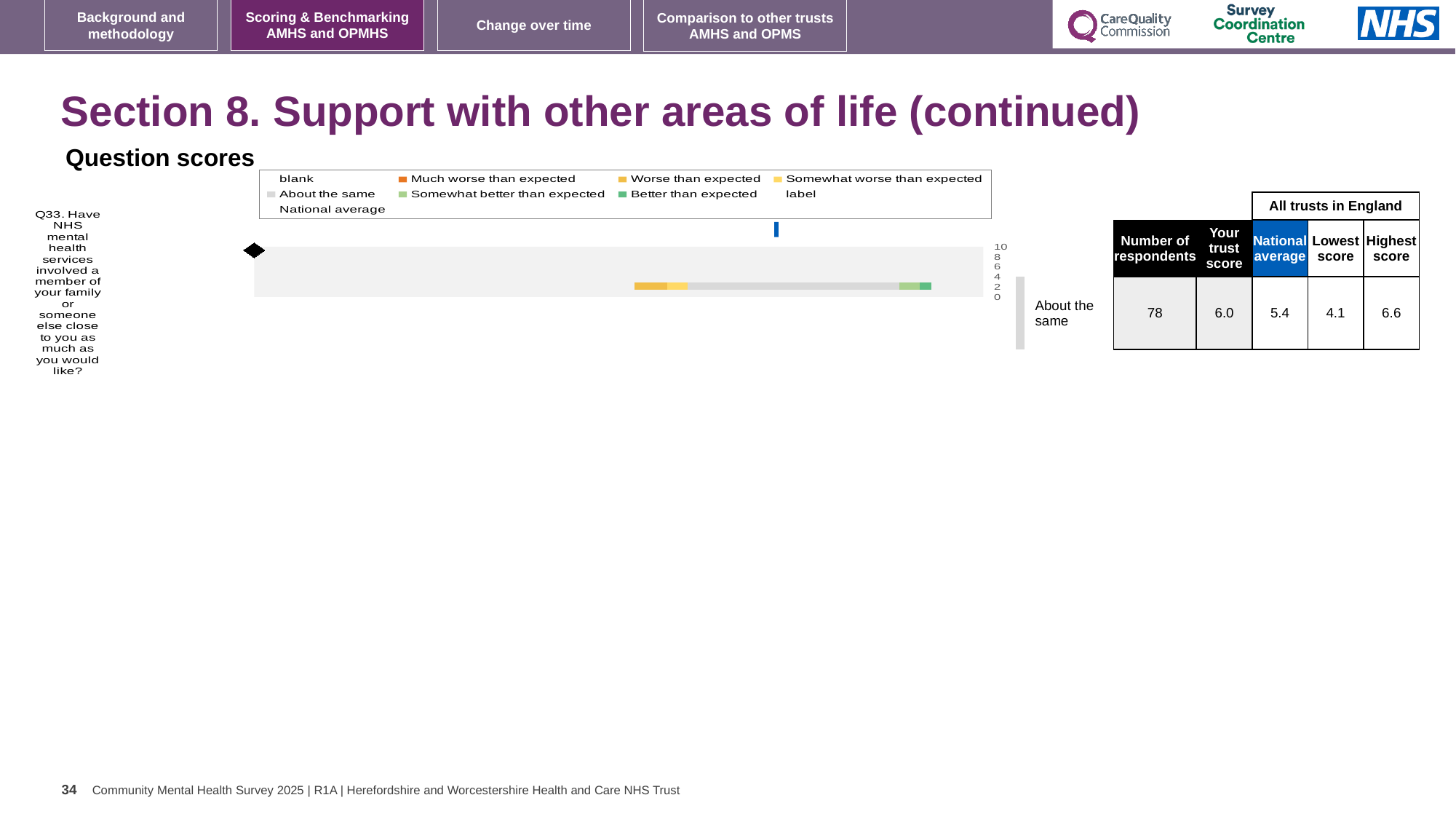
What is the highest score among all trusts in England for Q33? 6.6 What is the lowest score among all trusts in England for Q33? 4.1 How many questions (categories) are plotted in the Question scores chart? 1 What is the trust score for Q33? 6.0 How many respondents answered Q33? 78 What is the highest value shown on the chart's score axis? 10 What is the national average score for Q33? 5.4 Which is larger for Q33, the trust score or the national average? trust score What kind of chart is shown under 'Question scores'? bar chart What is the difference between the highest score and the lowest score for Q33? 2.5 What benchmark category is shown next to the bar for Q33? About the same Which question is plotted in the Question scores chart? Q33. Have NHS mental health services involved a member of your family or someone else close to you as much as you would like?